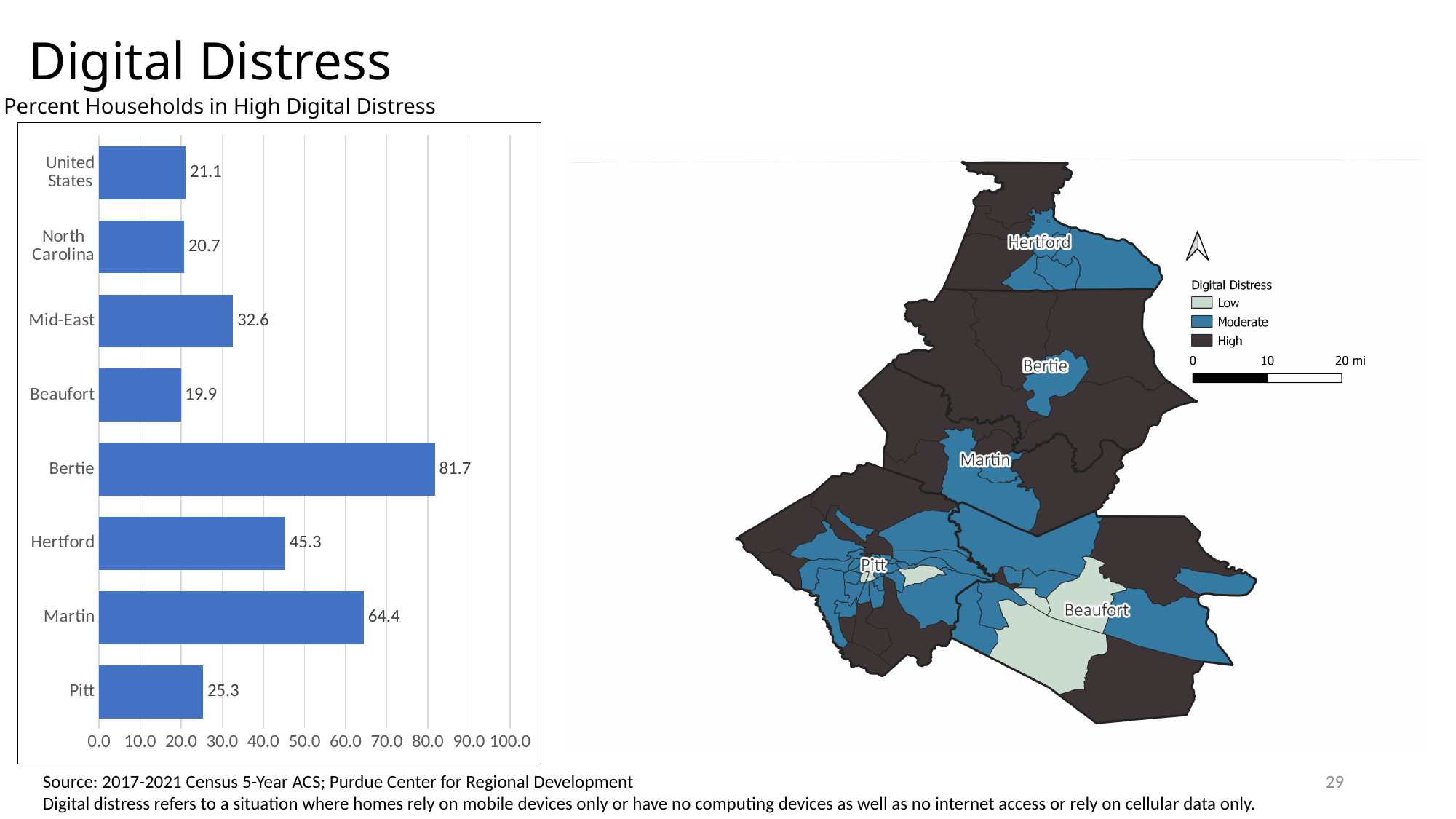
Which category has the lowest value in the bar chart? Beaufort What is the value for North Carolina in the bar chart? 20.7 Which is larger in the bar chart, the value for Mid-East or the value for United States? Mid-East What is the value for Pitt in the bar chart? 25.3 What is the difference between the values for Hertford and Pitt in the bar chart? 20.0 What is the difference between the values for Bertie and Martin in the bar chart? 17.3 What is the value for Bertie in the Percent Households in High Digital Distress chart? 81.7 What is the title of the bar chart on the slide? Percent Households in High Digital Distress Which category has the highest value in the bar chart? Bertie Is the value for Martin in the bar chart greater or less than 60.0? greater What kind of chart is used to show Percent Households in High Digital Distress? bar chart How many categories are shown in the bar chart? 8